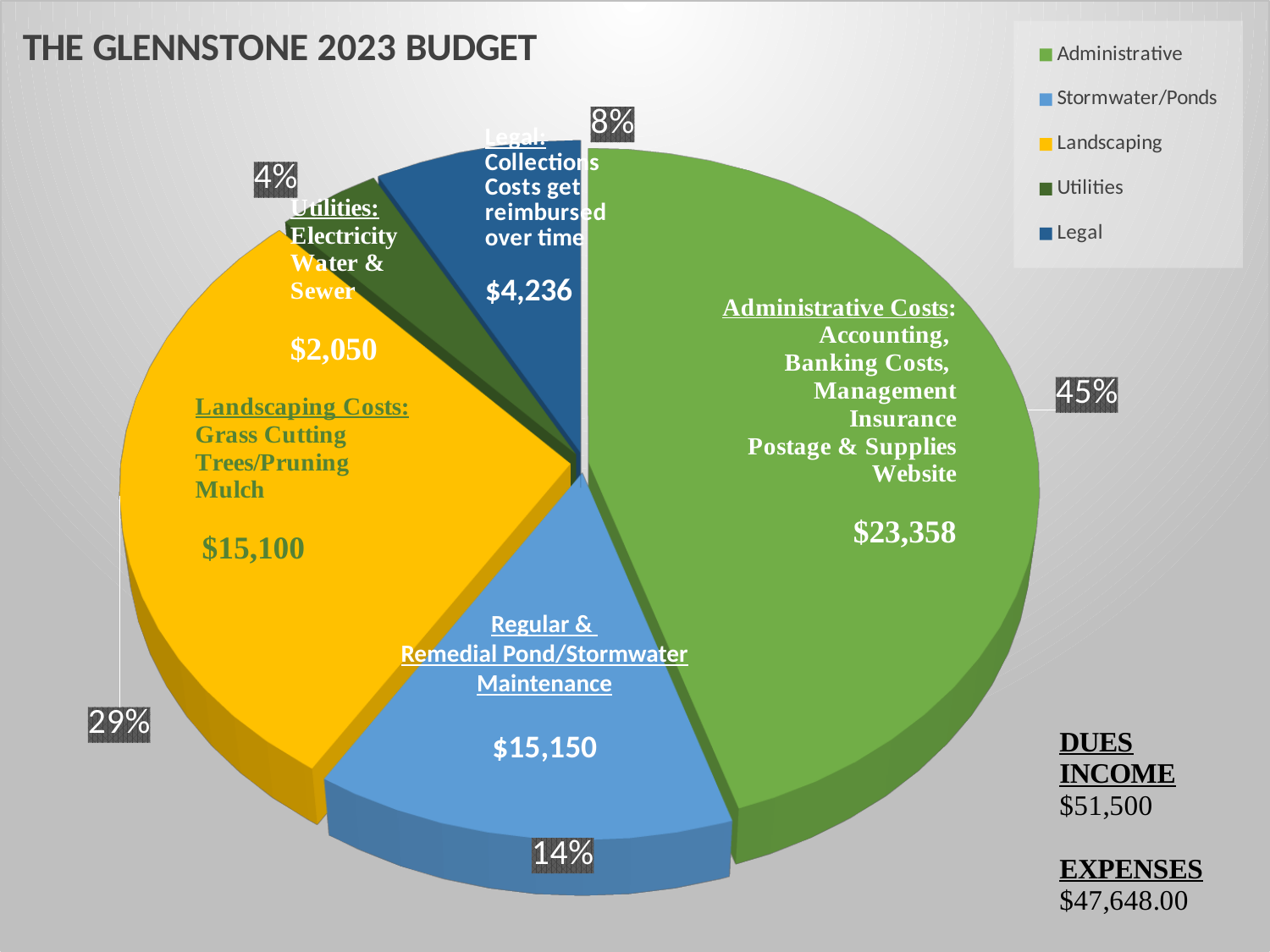
What percentage of the budget is Legal? 8% Which colour represents Landscaping in the pie chart? yellow Which category has the smallest share of the budget? Utilities What kind of chart is shown on the slide? pie chart What is the difference in dollars between Administrative Costs and Landscaping Costs? $8,258 What is the dollar amount for Utilities? $2,050 What percentage of the budget is Landscaping? 29% How many series does the legend list? 5 What is the dollar amount for Administrative Costs? $23,358 What percentage of the budget is Administrative? 45% Which category has the largest share of the budget? Administrative